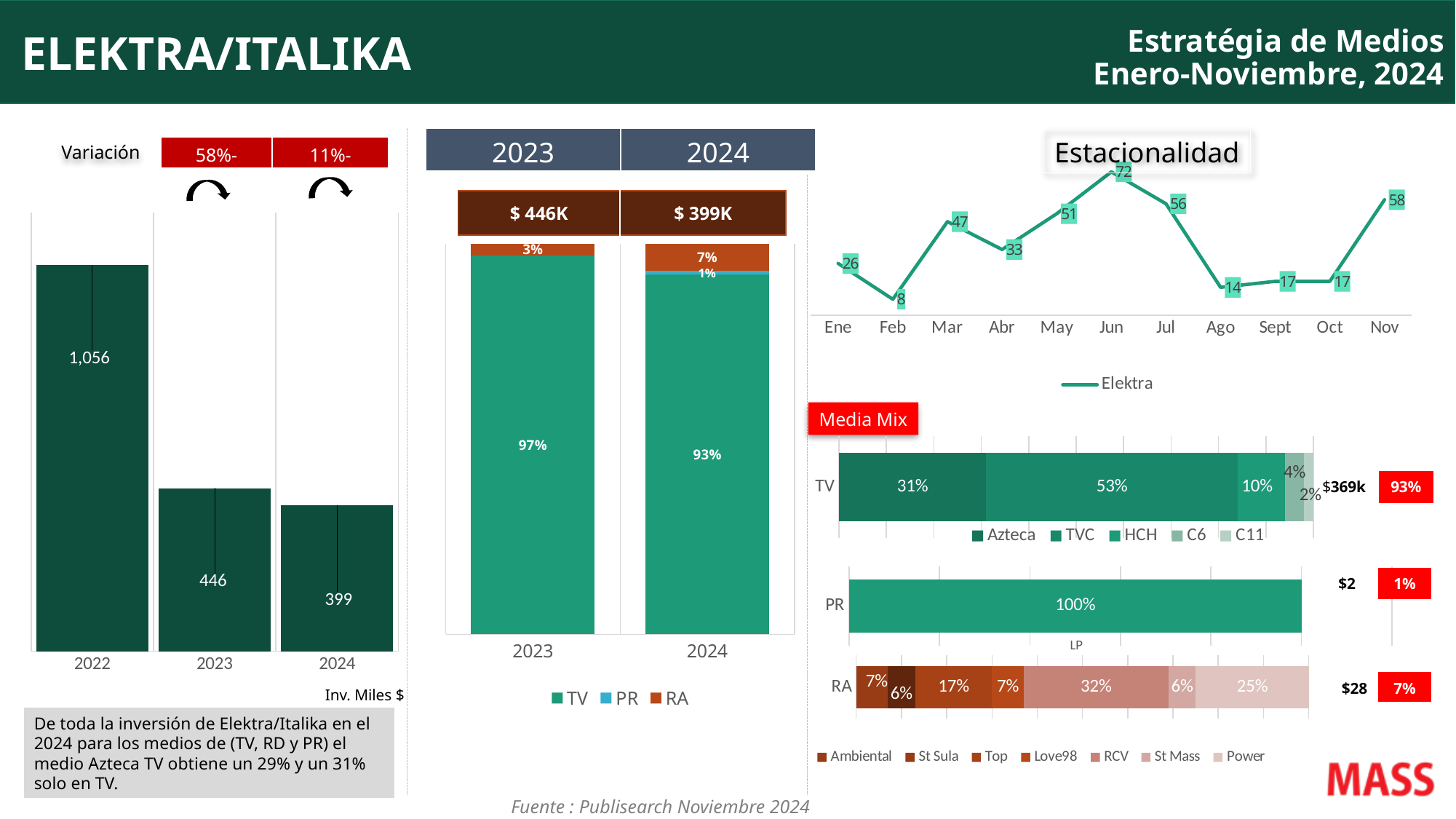
How many series does the legend of the middle stacked bar chart (2023 vs 2024) list? 3 In the bar chart on the left (Inv. Miles $), what is the difference between the values for 2023 and 2024? 47 In the bar chart on the left (Inv. Miles $), do the values rise or fall from 2022 to 2024? fall In the bar chart on the left (Inv. Miles $), which year has the highest value? 2022 In the Estacionalidad chart, which month has the lowest value? Feb In the middle stacked bar chart (2023 vs 2024), what share does TV have in 2024? 93% In the Estacionalidad chart, which is larger, the value for Mar or the value for Jul? Jul In the Estacionalidad chart, how many months are plotted? 11 In the Media Mix chart, what share does TVC have in the TV bar? 53% In the middle stacked bar chart (2023 vs 2024), what share does RA have in 2023? 3% In the Estacionalidad chart, what is the value for Jun? 72 In the bar chart on the left (Inv. Miles $), what is the value for 2022? 1,056